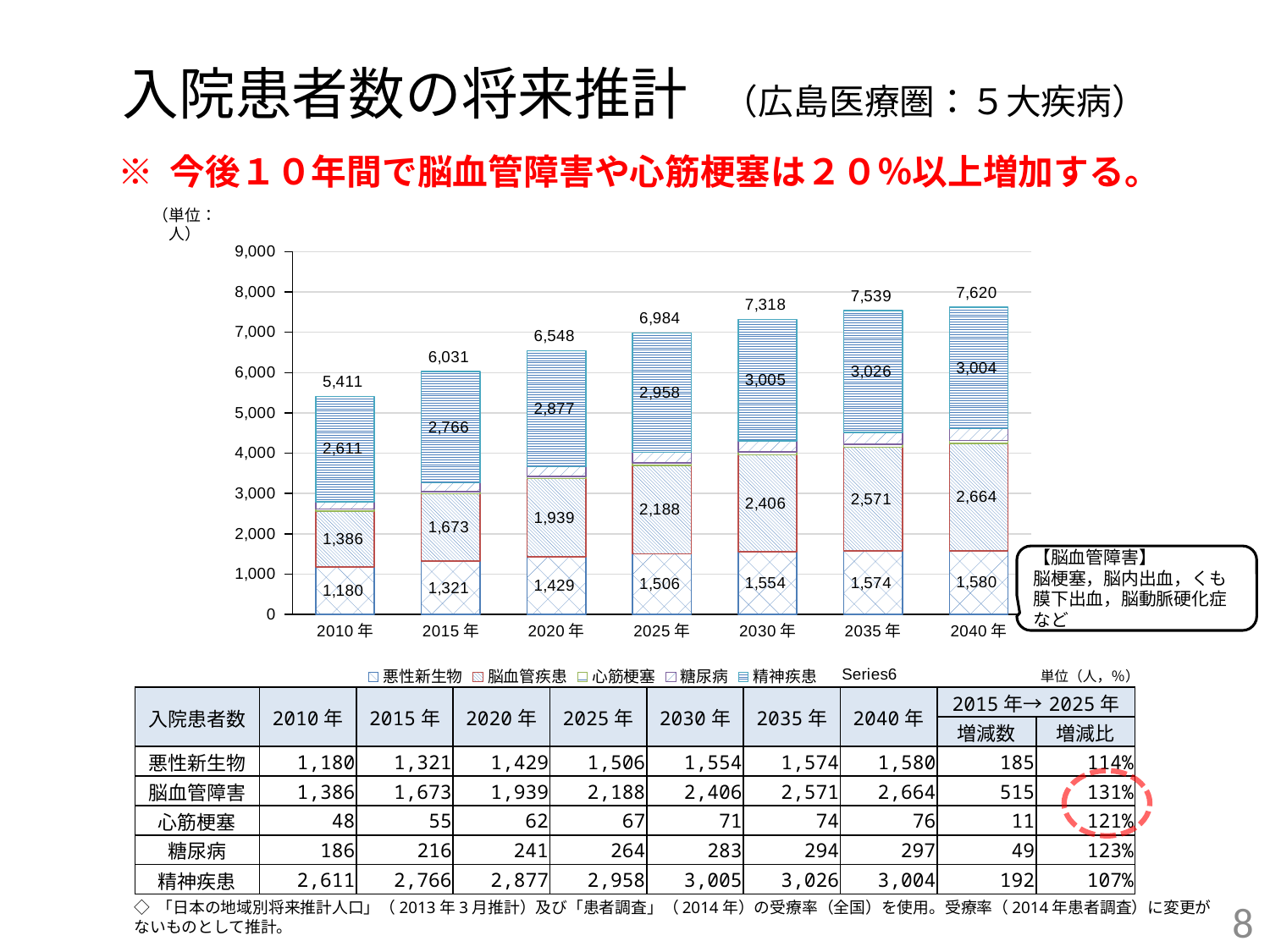
What is the difference between the total for 2040年 and the total for 2010年? 2,209 Do the total bar values rise or fall from 2010年 to 2040年? rise How many entries does the chart legend list? 6 What is the value of the 脳血管疾患 segment in the 2025年 bar? 2,188 What is the value of the 悪性新生物 segment in the 2020年 bar? 1,429 Which year has the highest total bar in the chart? 2040年 What is the total value labeled on top of the bar for 2010年? 5,411 What type of chart is shown on the slide? stacked bar chart What is the total value labeled on top of the bar for 2040年? 7,620 Which year has the lowest total bar in the chart? 2010年 How many year categories are plotted along the x axis of the chart? 7 What is the value of the 精神疾患 segment in the 2035年 bar? 3,026